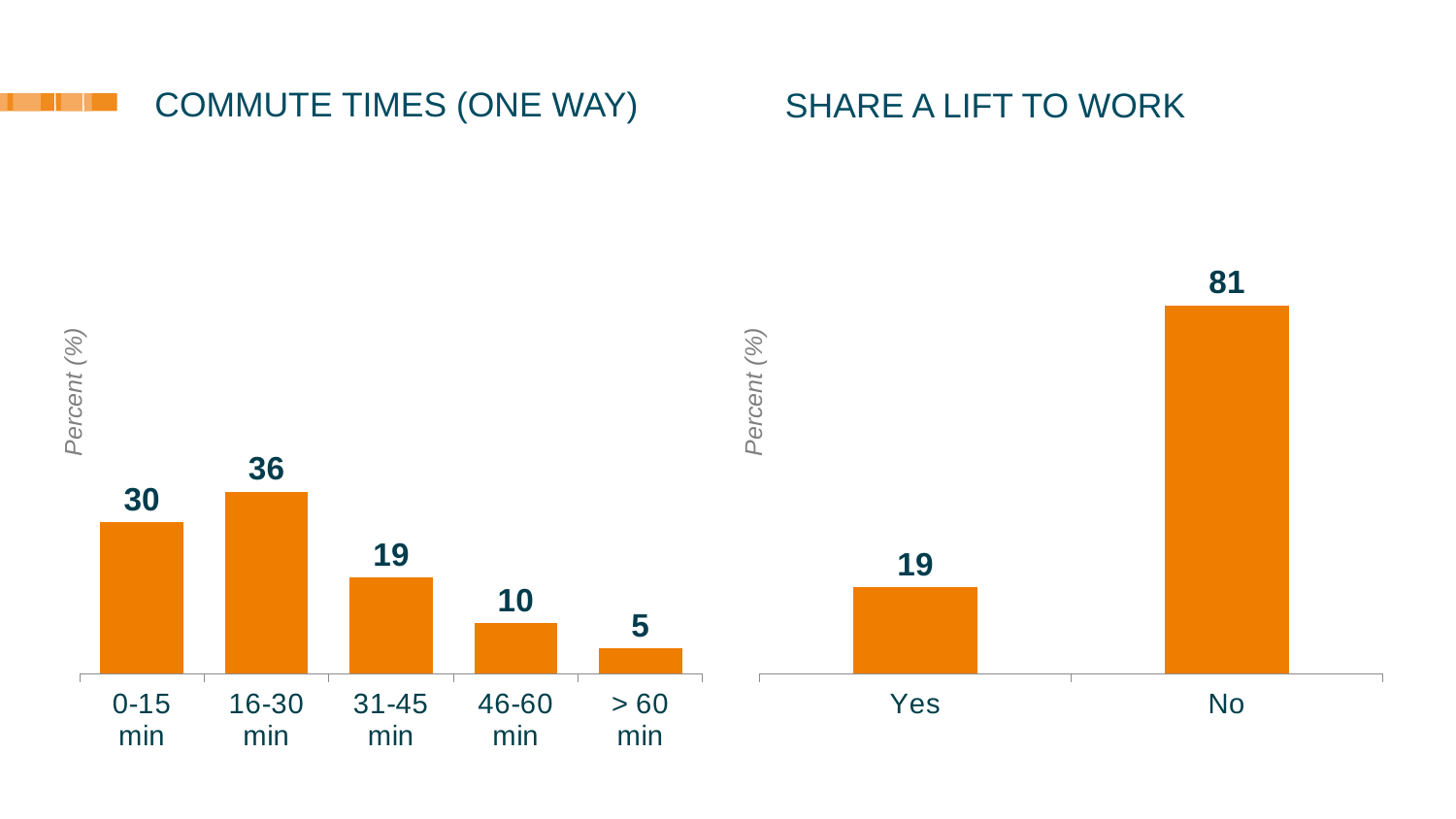
What kind of chart is the 'Share a Lift to Work' chart? bar chart In the 'Commute Times (One Way)' chart, what is the value for 16-30 min? 36 In the 'Commute Times (One Way)' chart, what is the value for > 60 min? 5 In the 'Commute Times (One Way)' chart, which is larger, the value for 46-60 min or the value for 31-45 min? 31-45 min In the 'Share a Lift to Work' chart, what is the difference between the values for No and Yes? 62 In the 'Commute Times (One Way)' chart, which category has the highest value? 16-30 min In the 'Share a Lift to Work' chart, what is the value for No? 81 What is the y-axis label of the 'Commute Times (One Way)' chart? Percent (%) In the 'Commute Times (One Way)' chart, which category has the lowest value? > 60 min In the 'Commute Times (One Way)' chart, do the values rise or fall from 16-30 min to > 60 min? fall How many categories are shown in the 'Commute Times (One Way)' chart? 5 In the 'Commute Times (One Way)' chart, what is the difference between the values for 0-15 min and 31-45 min? 11